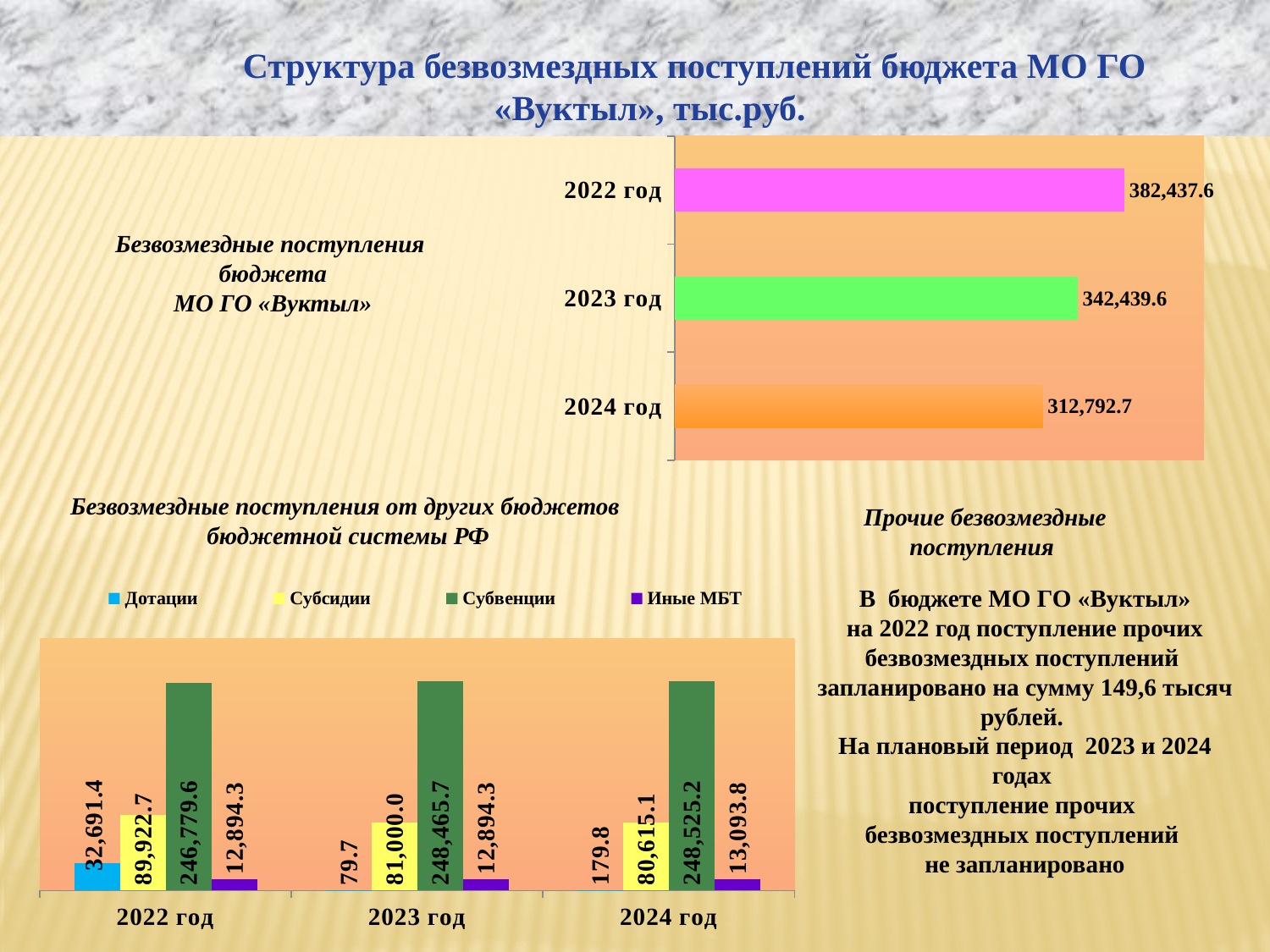
In the bottom chart (Безвозмездные поступления от других бюджетов бюджетной системы РФ), which series has the lowest value for 2024 год? Дотации In the top chart (Безвозмездные поступления бюджета МО ГО «Вуктыл»), do the values rise or fall from 2022 год to 2024 год? fall In the top chart (Безвозмездные поступления бюджета МО ГО «Вуктыл»), which year has the highest value? 2022 год In the top chart (Безвозмездные поступления бюджета МО ГО «Вуктыл»), what is the value for 2024 год? 312,792.7 What kind of chart is the top chart (Безвозмездные поступления бюджета МО ГО «Вуктыл»)? bar chart In the bottom chart (Безвозмездные поступления от других бюджетов бюджетной системы РФ), which is larger: Субсидии for 2022 год or Субсидии for 2023 год? Субсидии for 2022 год In the bottom chart (Безвозмездные поступления от других бюджетов бюджетной системы РФ), what is the value of Субвенции for 2023 год? 248,465.7 In the top chart (Безвозмездные поступления бюджета МО ГО «Вуктыл»), what is the difference between the 2022 год and 2023 год values? 39,998.0 In the bottom chart (Безвозмездные поступления от других бюджетов бюджетной системы РФ), what is the difference between Иные МБТ for 2024 год and 2023 год? 199.5 In the bottom chart (Безвозмездные поступления от других бюджетов бюджетной системы РФ), what is the value of Дотации for 2022 год? 32,691.4 In the bottom chart (Безвозмездные поступления от других бюджетов бюджетной системы РФ), how many series does the legend list? 4 In the top chart (Безвозмездные поступления бюджета МО ГО «Вуктыл»), what is the value for 2022 год? 382,437.6